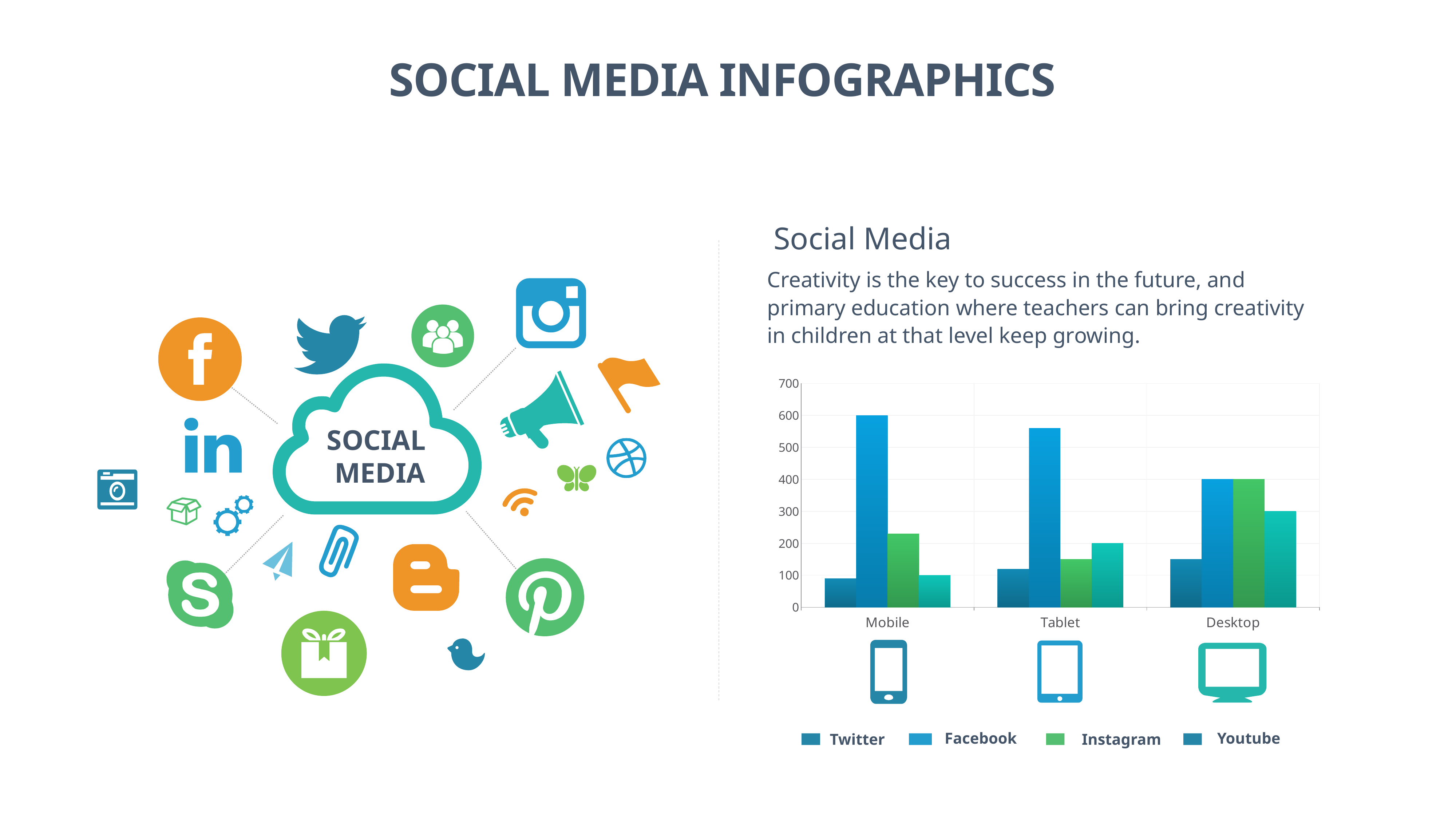
How many categories are shown on the x axis of the bar chart? 3 Is the value for Youtube on Desktop greater or less than 200? greater Which series has the lowest value for Desktop? Twitter Is the value for Twitter on Mobile greater or less than 200? less Which is larger, the Facebook value for Mobile or the Facebook value for Desktop? Mobile What kind of chart is shown on the slide? bar chart Which is larger for Tablet, the Instagram value or the Youtube value? Youtube Which series has the lowest value for Tablet? Twitter How many series does the legend of the bar chart list? 4 Which series is listed last in the legend of the bar chart? Youtube Which series has the highest value for Mobile? Facebook Is the value for Facebook on Mobile greater or less than 500? greater